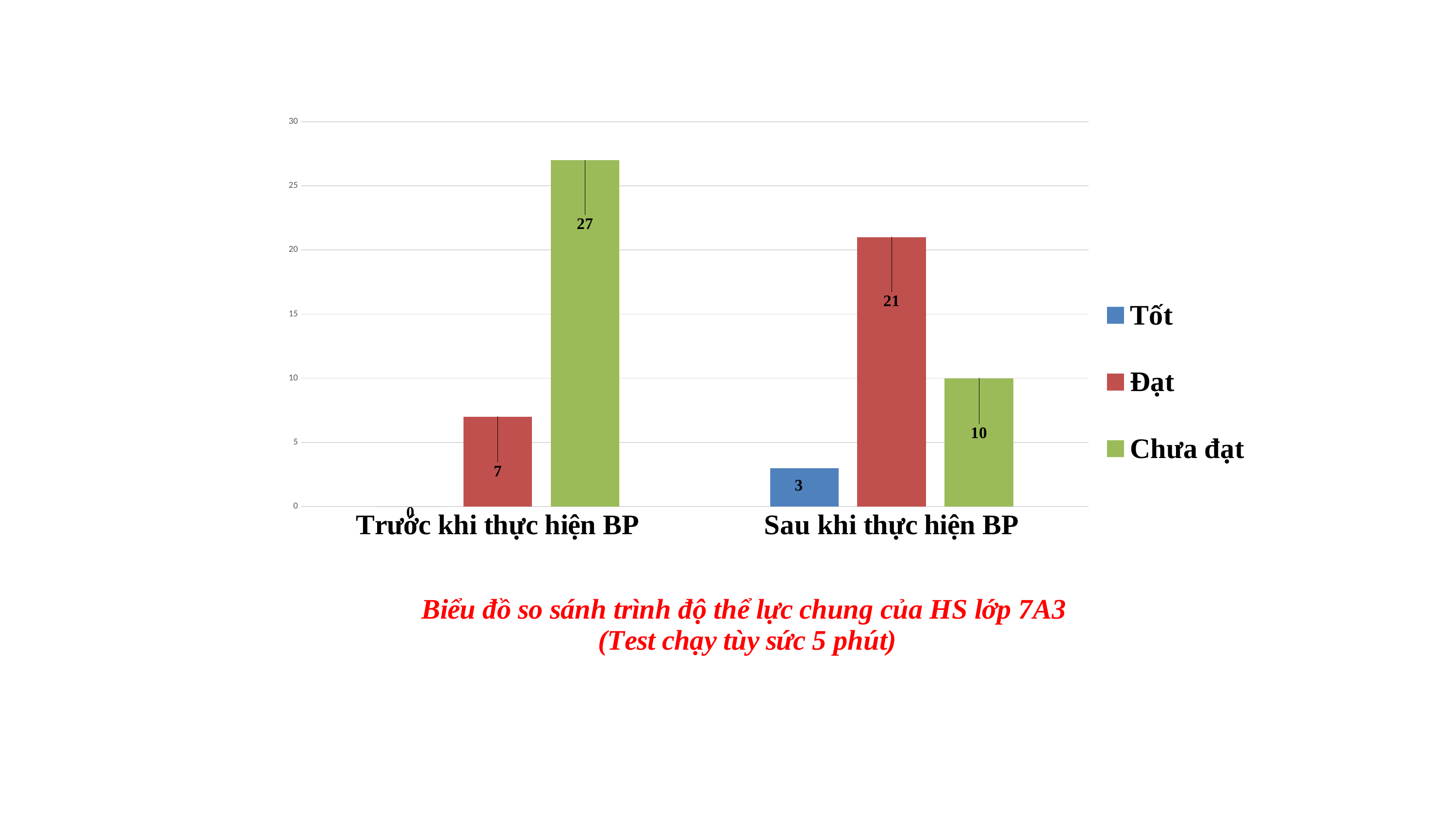
What is the value for Đạt in the Sau khi thực hiện BP category? 21 What kind of chart is shown on the slide? bar chart How many series does the legend list? 3 How many categories are shown on the x axis? 2 What is the value for Tốt in the Sau khi thực hiện BP category? 3 Is the value for Đạt in the Sau khi thực hiện BP category greater or less than 20? greater What is the difference between the Đạt values for Sau khi thực hiện BP and Trước khi thực hiện BP? 14 What is the value for Chưa đạt in the Trước khi thực hiện BP category? 27 What is the value for Tốt in the Trước khi thực hiện BP category? 0 Which series has the lowest value in the Sau khi thực hiện BP category? Tốt Which series has the highest value in the Trước khi thực hiện BP category? Chưa đạt Which is larger: Chưa đạt for Trước khi thực hiện BP or Chưa đạt for Sau khi thực hiện BP? Chưa đạt for Trước khi thực hiện BP